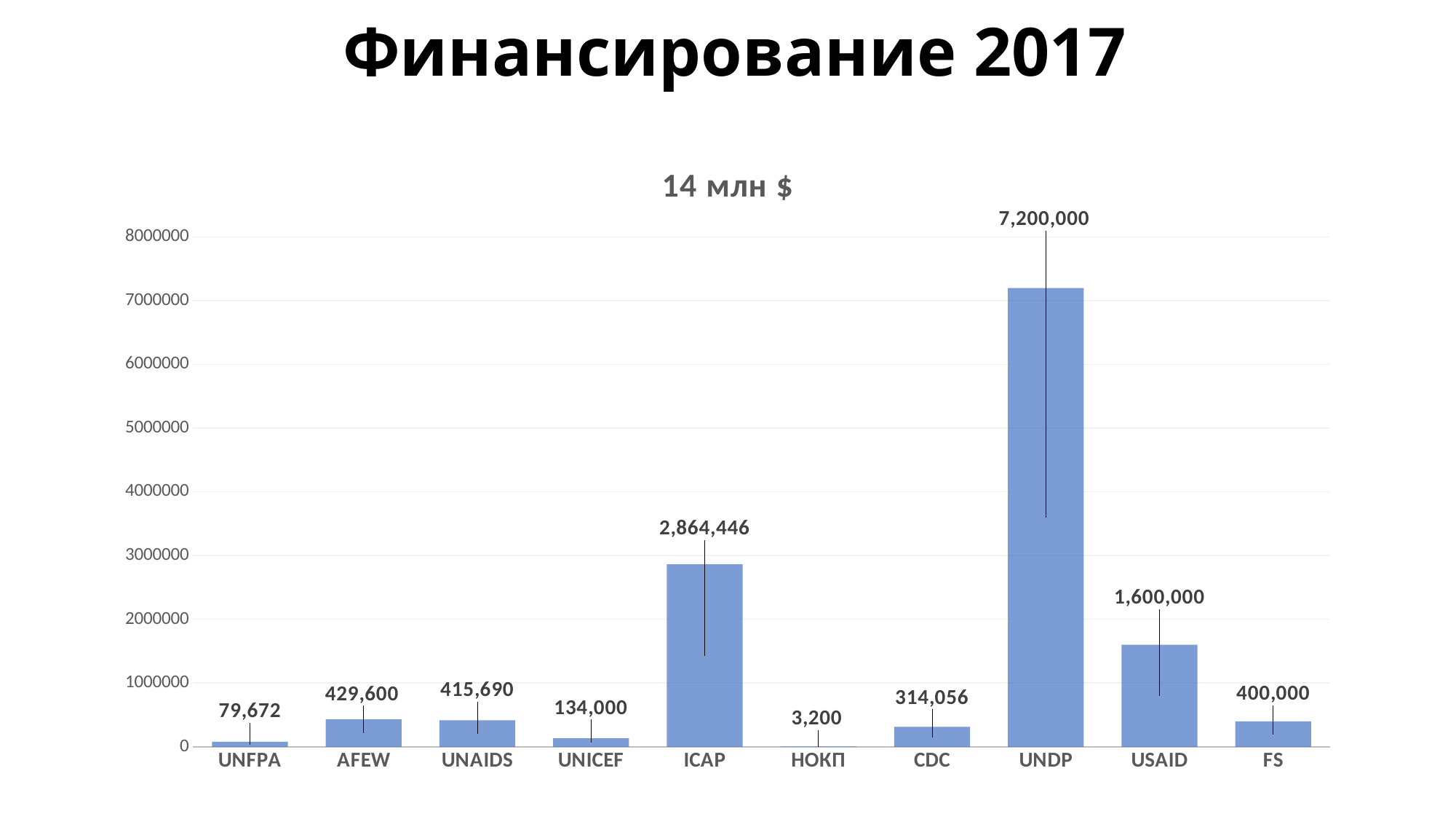
What is the value for НОКП? 3,200 What is the difference between the values for AFEW and UNAIDS? 13,910 What is the value for UNDP? 7,200,000 What is the value for CDC? 314,056 Which is larger, the value for FS or the value for UNICEF? FS What is the difference between the values for UNDP and USAID? 5,600,000 How many categories are shown on the x axis? 10 What is the value for ICAP? 2,864,446 Which category has the lowest value? НОКП What is the chart's title? 14 млн $ What kind of chart is shown on the slide? Bar chart Which category has the highest value? UNDP